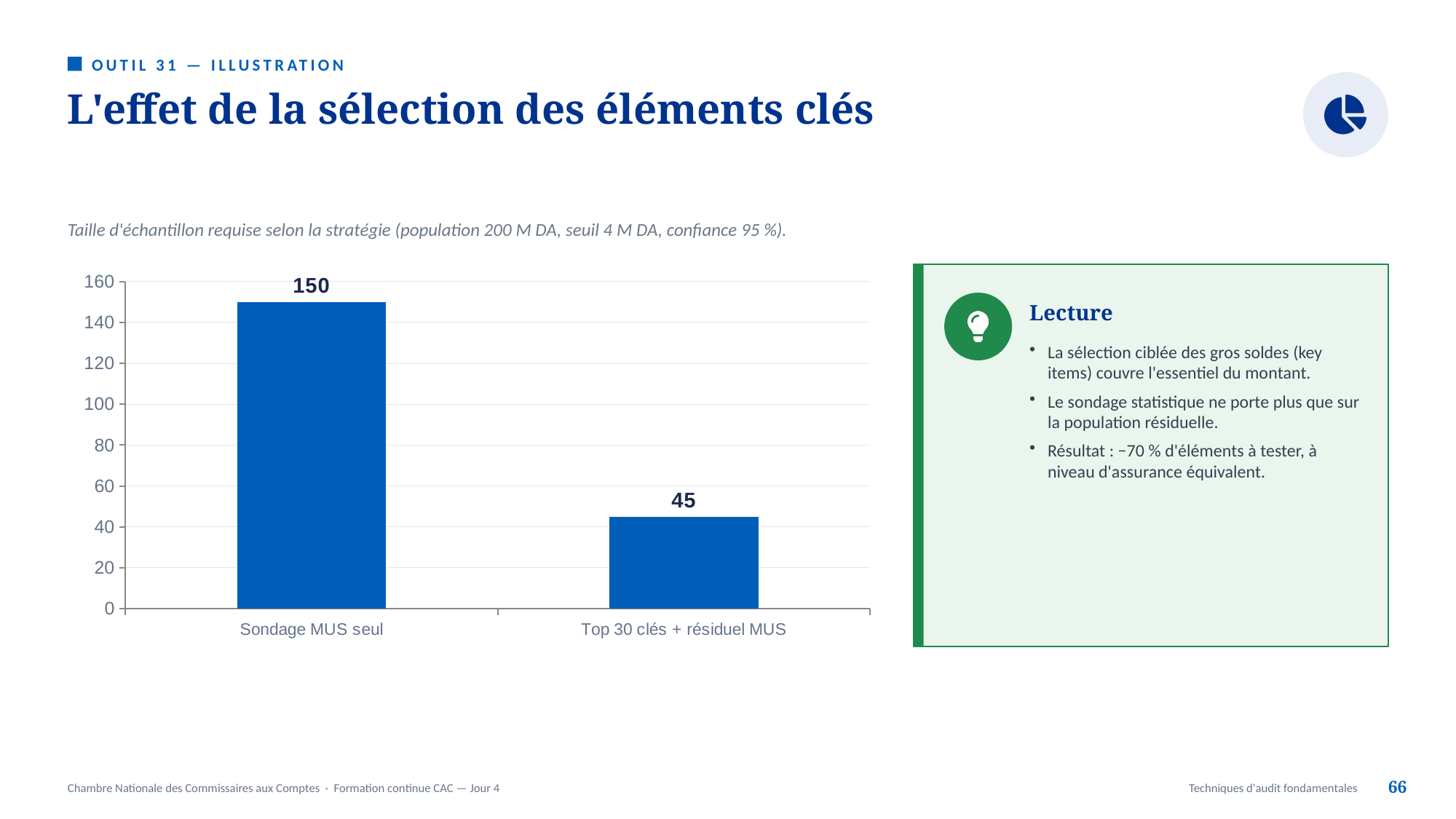
What is the value for Sondage MUS seul? 150 Which is larger, the value for Sondage MUS seul or the value for Top 30 clés + résiduel MUS? Sondage MUS seul Is the value for Sondage MUS seul greater or less than 140? greater How many categories are shown on the chart? 2 Is the value for Top 30 clés + résiduel MUS greater or less than 60? less What is the highest value shown on the vertical axis of the chart? 160 What is the value for Top 30 clés + résiduel MUS? 45 Which category has the lowest value? Top 30 clés + résiduel MUS What kind of chart is shown on the slide? bar chart What is the difference between the values for Sondage MUS seul and Top 30 clés + résiduel MUS? 105 Which category has the highest value? Sondage MUS seul Do the values rise or fall from left to right along the x axis? fall